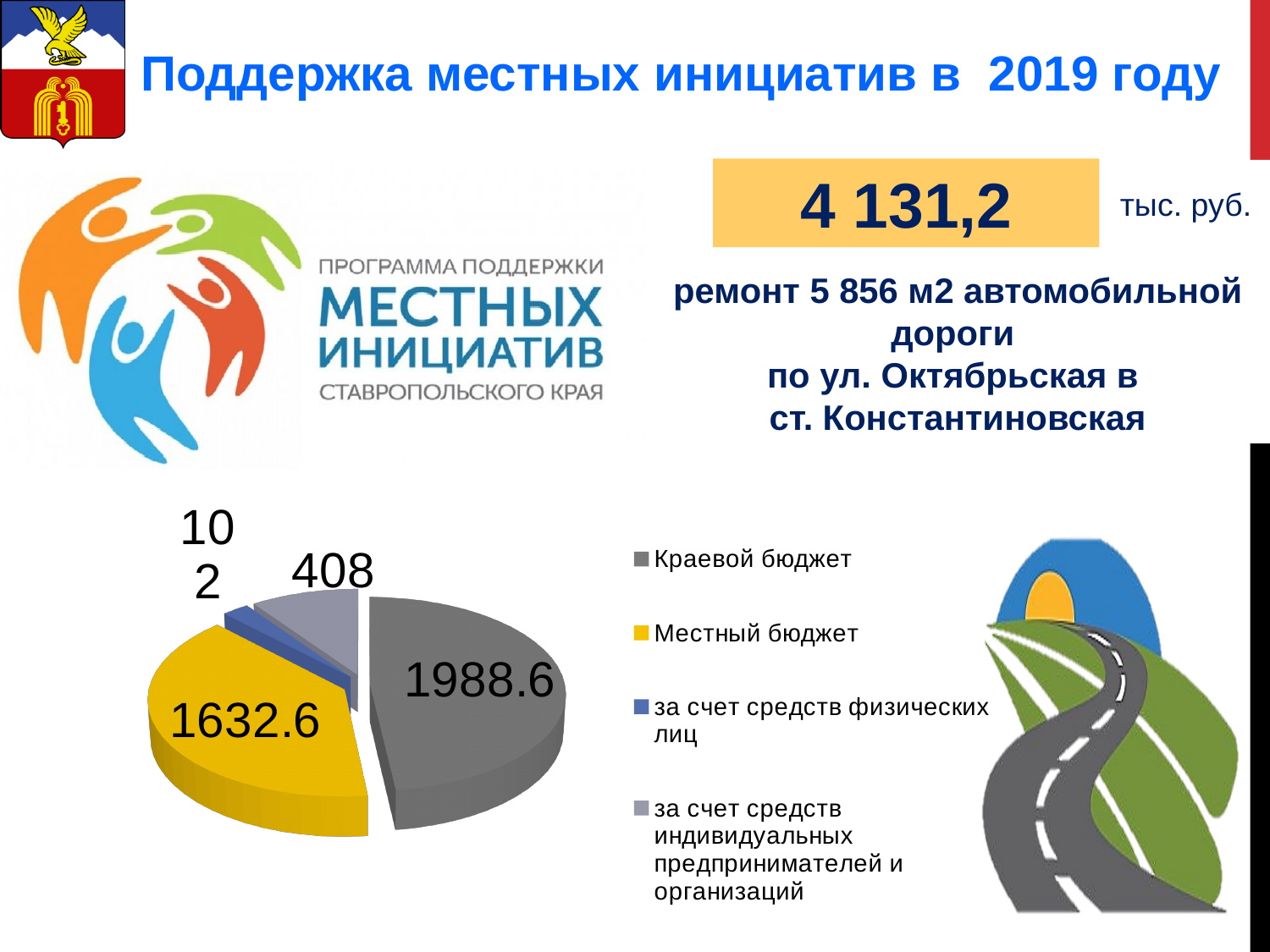
What is the value for за счет средств индивидуальных предпринимателей и организаций in the pie chart? 408 What is the difference between Краевой бюджет and Местный бюджет in the pie chart? 356 What is the value for Краевой бюджет in the pie chart? 1988.6 What colour is the Местный бюджет slice in the pie chart? yellow How many slices does the pie chart have? 4 Which category has the largest slice in the pie chart? Краевой бюджет What type of chart is shown on the slide? pie chart Which category has the smallest slice in the pie chart? за счет средств физических лиц What is the value for Местный бюджет in the pie chart? 1632.6 What is the value for за счет средств физических лиц in the pie chart? 102 Which is larger in the pie chart: Местный бюджет or за счет средств индивидуальных предпринимателей и организаций? Местный бюджет How many entries does the legend of the pie chart list? 4